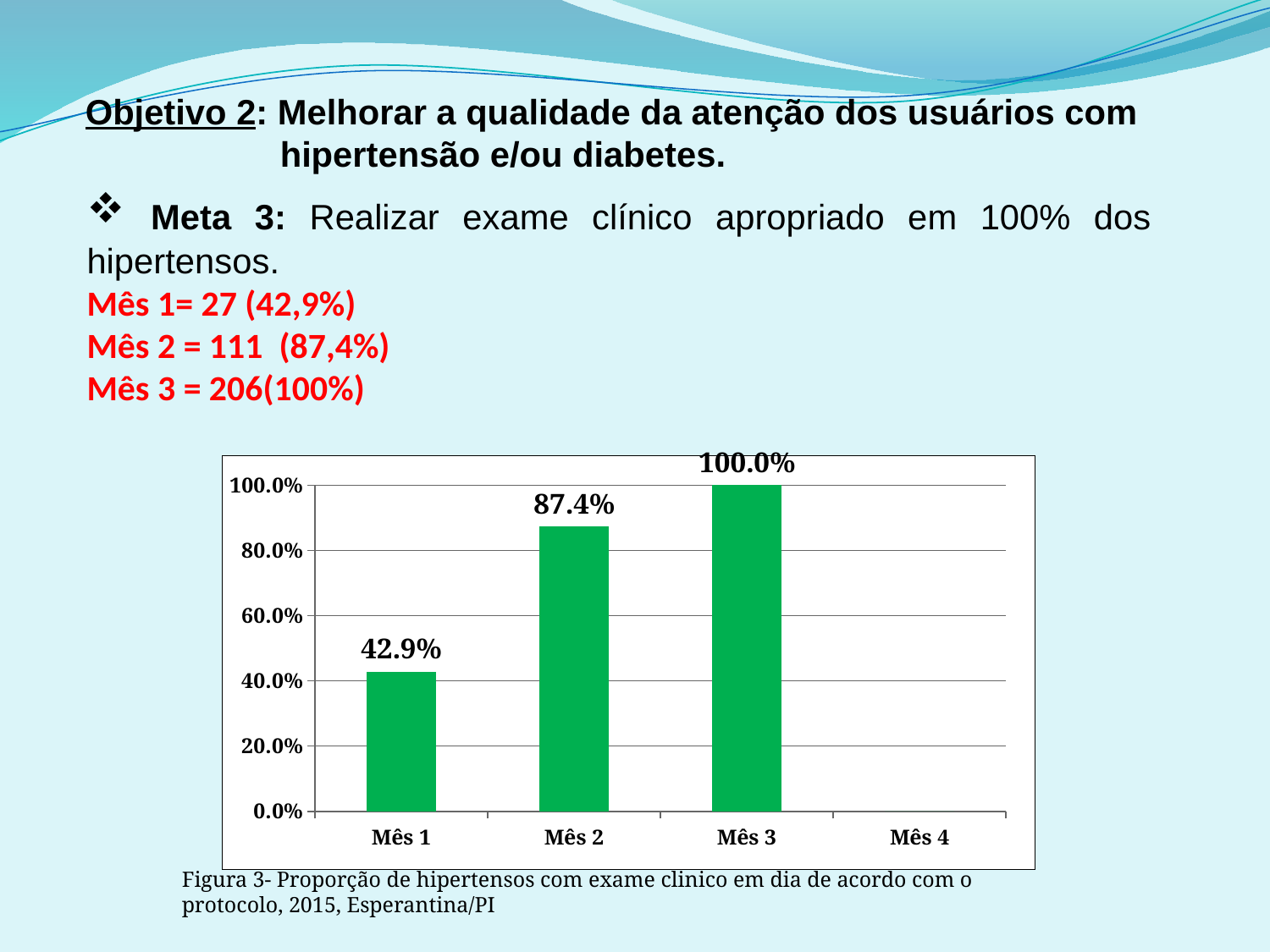
Is the value for Mês 1 greater or less than 60.0%? less What is the value for Mês 1? 42.9% Which is larger, the value for Mês 1 or the value for Mês 2? Mês 2 Which month with a plotted bar has the lowest value? Mês 1 What kind of chart is shown on the slide? bar chart What is the value for Mês 3? 100.0% What is the difference between the values for Mês 2 and Mês 1? 44.5% Which month has the highest value? Mês 3 What is the value for Mês 2? 87.4% What is the difference between the values for Mês 3 and Mês 2? 12.6% Do the values rise or fall from Mês 1 to Mês 3? rise How many categories are shown on the x axis? 4